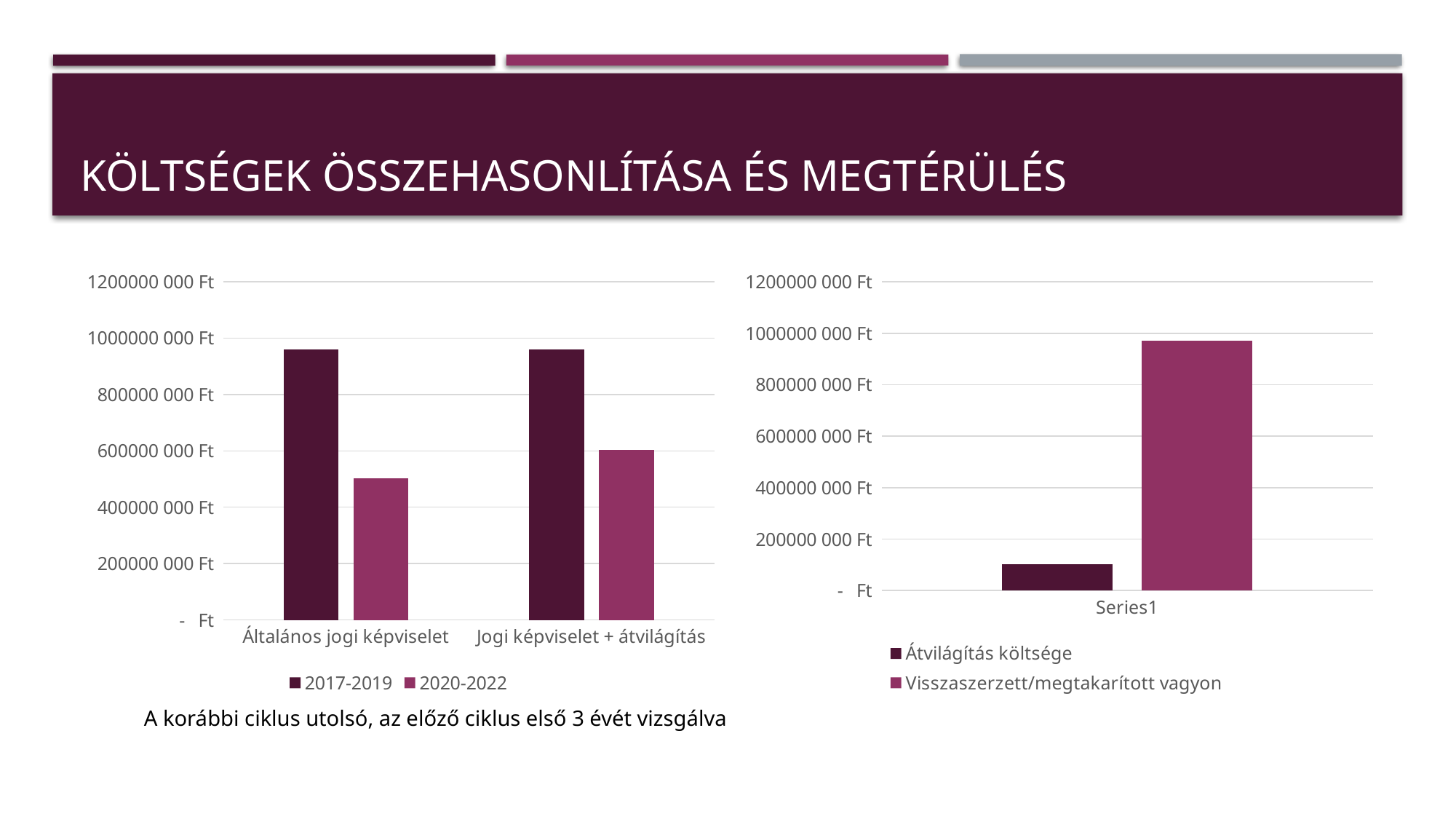
What kind of chart is the chart on the left of the slide? bar chart In the right chart, which series has the higher value, Átvilágítás költsége or Visszaszerzett/megtakarított vagyon? Visszaszerzett/megtakarított vagyon In the right chart, is the value for Visszaszerzett/megtakarított vagyon greater or less than 800000 000 Ft? greater In the left chart, is the 2020-2022 value for Általános jogi képviselet greater or less than 600000 000 Ft? less How many series does the legend of the right chart list? 2 What are the two legend entries of the left chart? 2017-2019 and 2020-2022 In the left chart, which series has the higher value for Általános jogi képviselet, 2017-2019 or 2020-2022? 2017-2019 How many categories are shown on the x axis of the left chart? 2 In the left chart, which category has the higher 2020-2022 value? Jogi képviselet + átvilágítás How many series does the legend of the left chart list? 2 In the right chart, is the value for Átvilágítás költsége greater or less than 200000 000 Ft? less